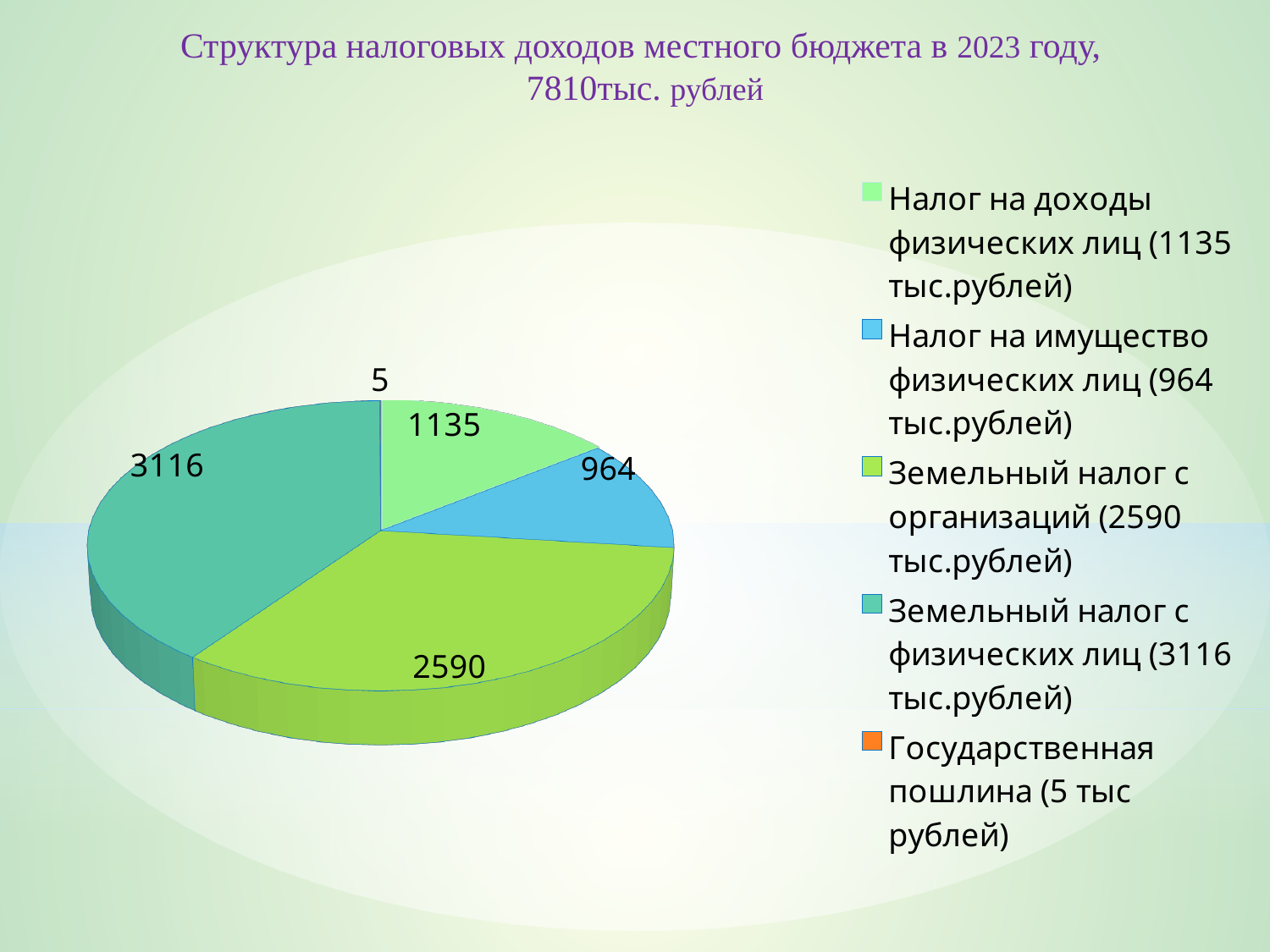
What is the value for Государственная пошлина? 5 Which is larger: Налог на доходы физических лиц or Налог на имущество физических лиц? Налог на доходы физических лиц Which category has the largest slice of the pie? Земельный налог с физических лиц Which category has the smallest slice of the pie? Государственная пошлина What kind of chart is shown on the slide? pie chart How many slices does the pie chart have? 5 What colour is the slice for Земельный налог с организаций? green What is the difference between the values for Земельный налог с физических лиц and Земельный налог с организаций? 526 What is the value for Налог на имущество физических лиц? 964 What is the value for Налог на доходы физических лиц? 1135 What is the total of all the slices in the pie chart? 7810 What is the value for Земельный налог с физических лиц? 3116